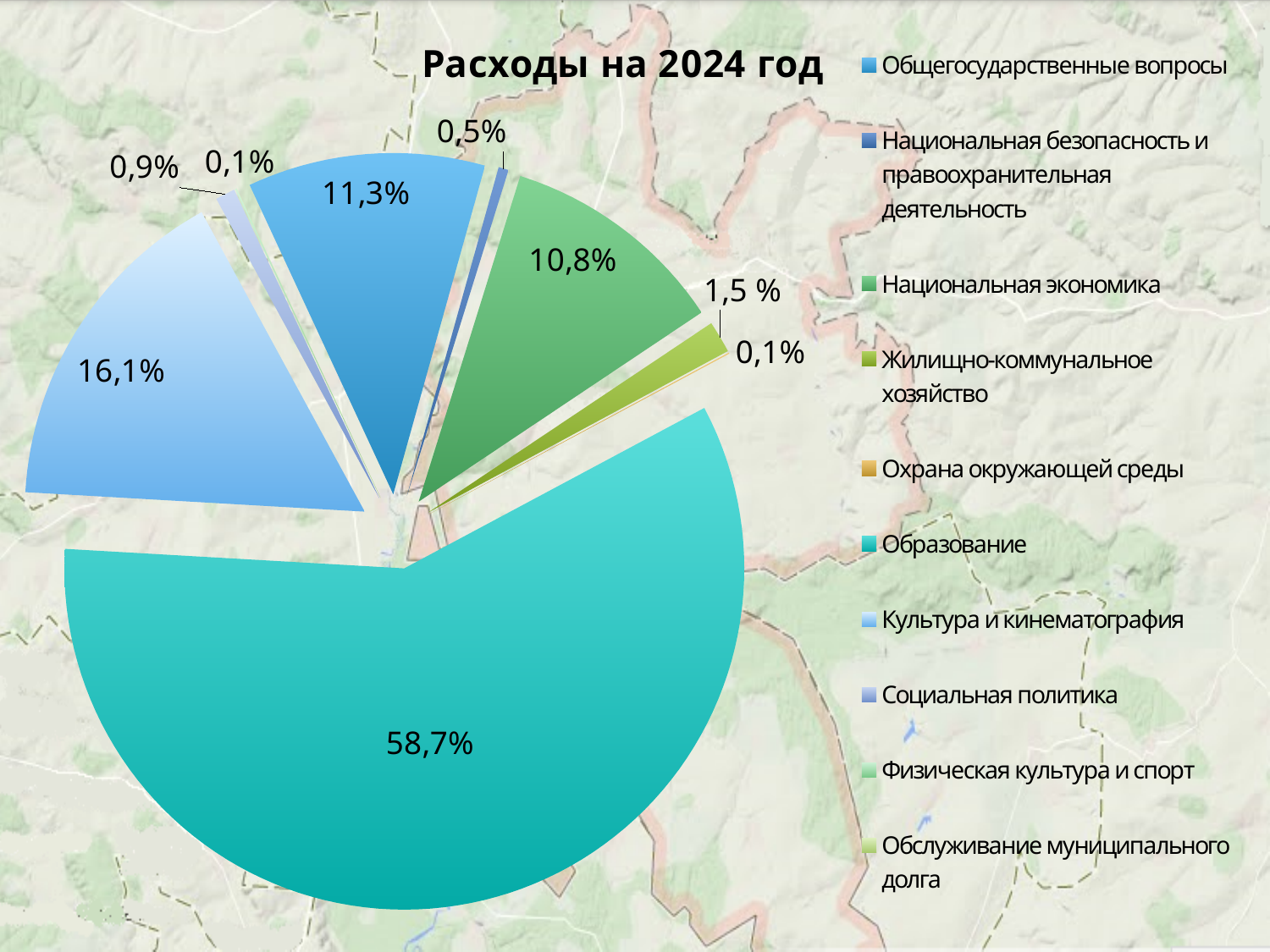
What share of the pie does Культура и кинематография have? 16,1% What is the value shown for Жилищно-коммунальное хозяйство? 1,5 % What is the value shown for Национальная безопасность и правоохранительная деятельность? 0,5% How many entries does the chart legend list? 10 What kind of chart is shown on the slide? pie chart What is the title of the chart? Расходы на 2024 год Which is larger, the share for Общегосударственные вопросы or for Национальная экономика? Общегосударственные вопросы Which category has the largest share of the pie? Образование What is the value shown for Общегосударственные вопросы? 11,3% What share of the pie does Образование have? 58,7% What is the difference in percentage points between the shares for Образование and Культура и кинематография? 42,6 What is the value shown for Национальная экономика? 10,8%